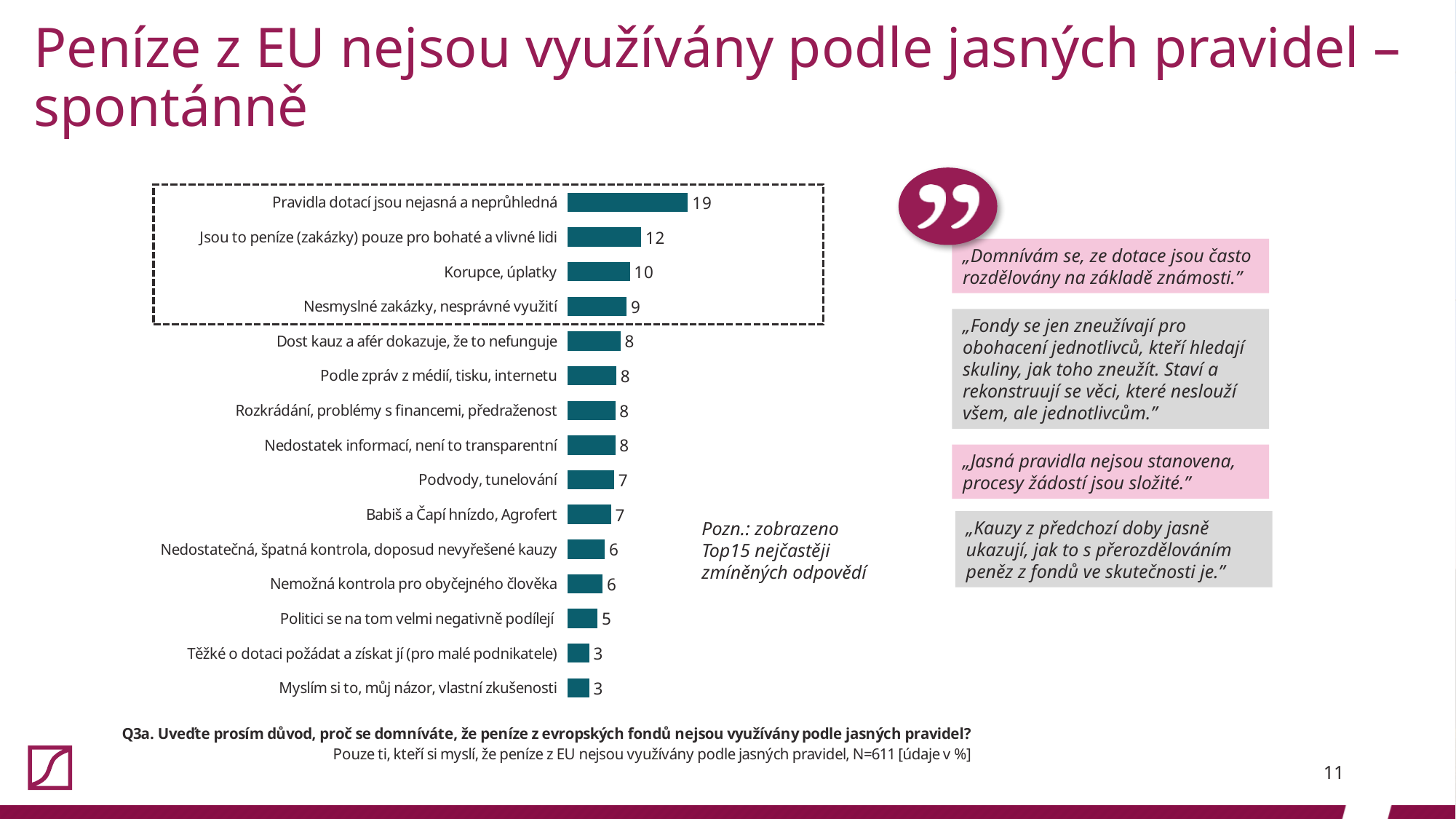
What value is shown for "Pravidla dotací jsou nejasná a neprůhledná"? 19 What kind of chart is shown on the slide? Bar chart What value is shown for "Korupce, úplatky"? 10 What is the difference between the values for "Nesmyslné zakázky, nesprávné využití" and "Těžké o dotaci požádat a získat jí (pro malé podnikatele)"? 6 How many categories are shown in the chart? 15 How many categories are enclosed in the dashed box at the top of the chart? 4 What value is shown for "Babiš a Čapí hnízdo, Agrofert"? 7 What is the difference between the values for "Pravidla dotací jsou nejasná a neprůhledná" and "Jsou to peníze (zakázky) pouze pro bohaté a vlivné lidi"? 7 Which category has the highest value in the chart? Pravidla dotací jsou nejasná a neprůhledná Which has a larger value: "Korupce, úplatky" or "Podvody, tunelování"? Korupce, úplatky What value is shown for "Politici se na tom velmi negativně podílejí"? 5 Which has a larger value: "Nemožná kontrola pro obyčejného člověka" or "Jsou to peníze (zakázky) pouze pro bohaté a vlivné lidi"? Jsou to peníze (zakázky) pouze pro bohaté a vlivné lidi